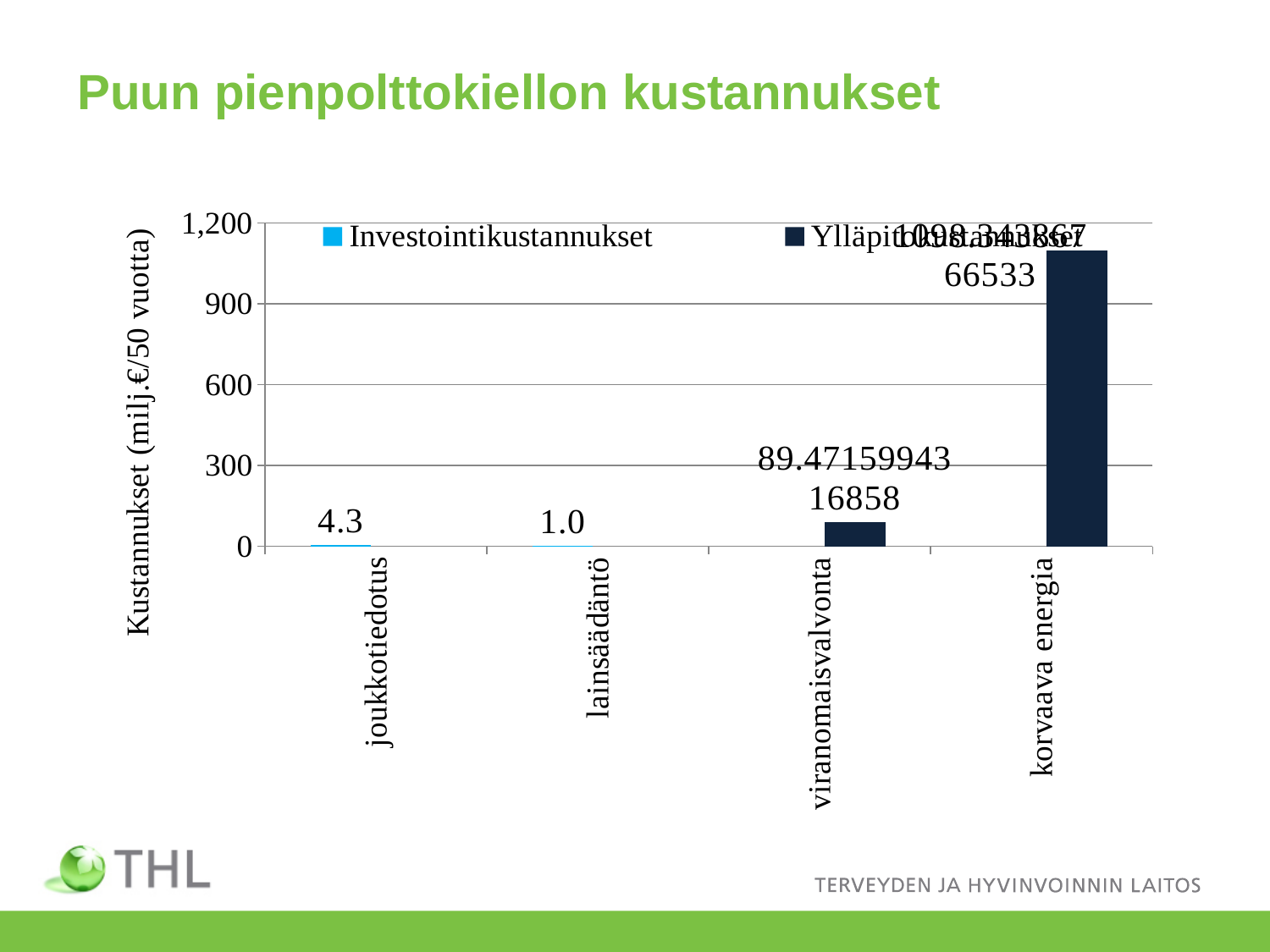
Is the value for viranomaisvalvonta greater or less than 300? less Which category has the highest cost in the chart? korvaava energia What value is labelled for joukkotiedotus? 4.3 Which category has the lowest labelled cost in the chart? lainsäädäntö How many series does the chart legend list? 2 What type of chart is shown on the slide? bar chart Is the value for korvaava energia greater or less than 900? greater What is the label on the vertical axis of the chart? Kustannukset (milj.€/50 vuotta) Which is larger, the value for korvaava energia or the value for viranomaisvalvonta? korvaava energia What is the difference between the labelled values for joukkotiedotus and lainsäädäntö? 3.3 What value is labelled for lainsäädäntö? 1.0 How many categories are shown on the x axis of the chart? 4